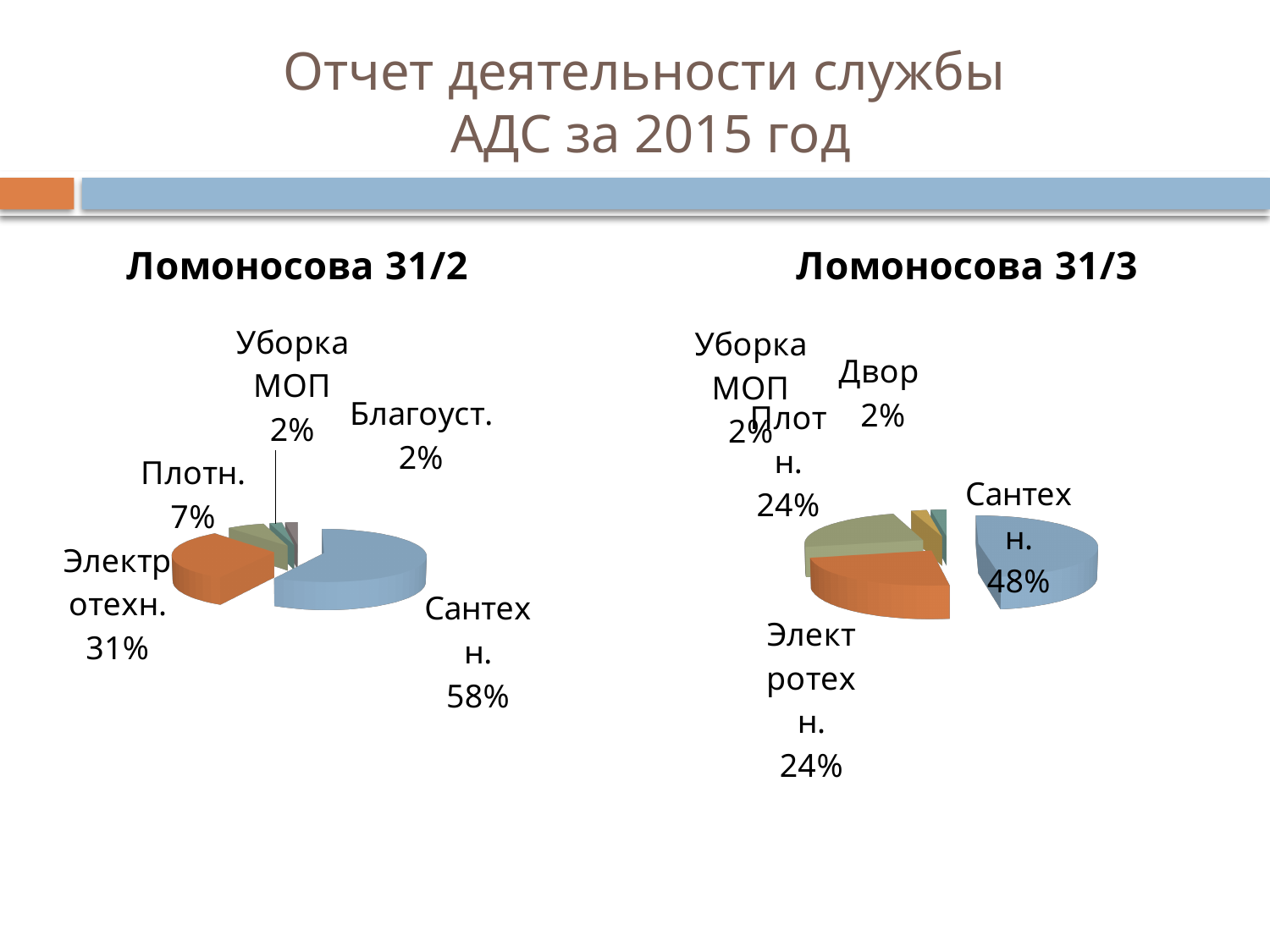
In the 'Ломоносова 31/2' chart, how many slices does the pie have? 5 In the 'Ломоносова 31/3' chart, what share does Двор have? 2% In the 'Ломоносова 31/2' chart, what is the difference between the Сантехн. and Электротехн. shares? 27% In the 'Ломоносова 31/2' chart, which category has the largest share? Сантехн. In the 'Ломоносова 31/3' chart, what share does Сантехн. have? 48% What type of chart is used for 'Ломоносова 31/2'? Pie chart In the 'Ломоносова 31/2' chart, what share does Электротехн. have? 31% In the 'Ломоносова 31/2' chart, what share does Плотн. have? 7% In the 'Ломоносова 31/3' chart, what share does Плотн. have? 24% In the 'Ломоносова 31/3' chart, which category has the largest share? Сантехн. In the 'Ломоносова 31/2' chart, what share does Сантехн. have? 58% In the 'Ломоносова 31/3' chart, what is the difference between the Сантехн. and Электротехн. shares? 24%